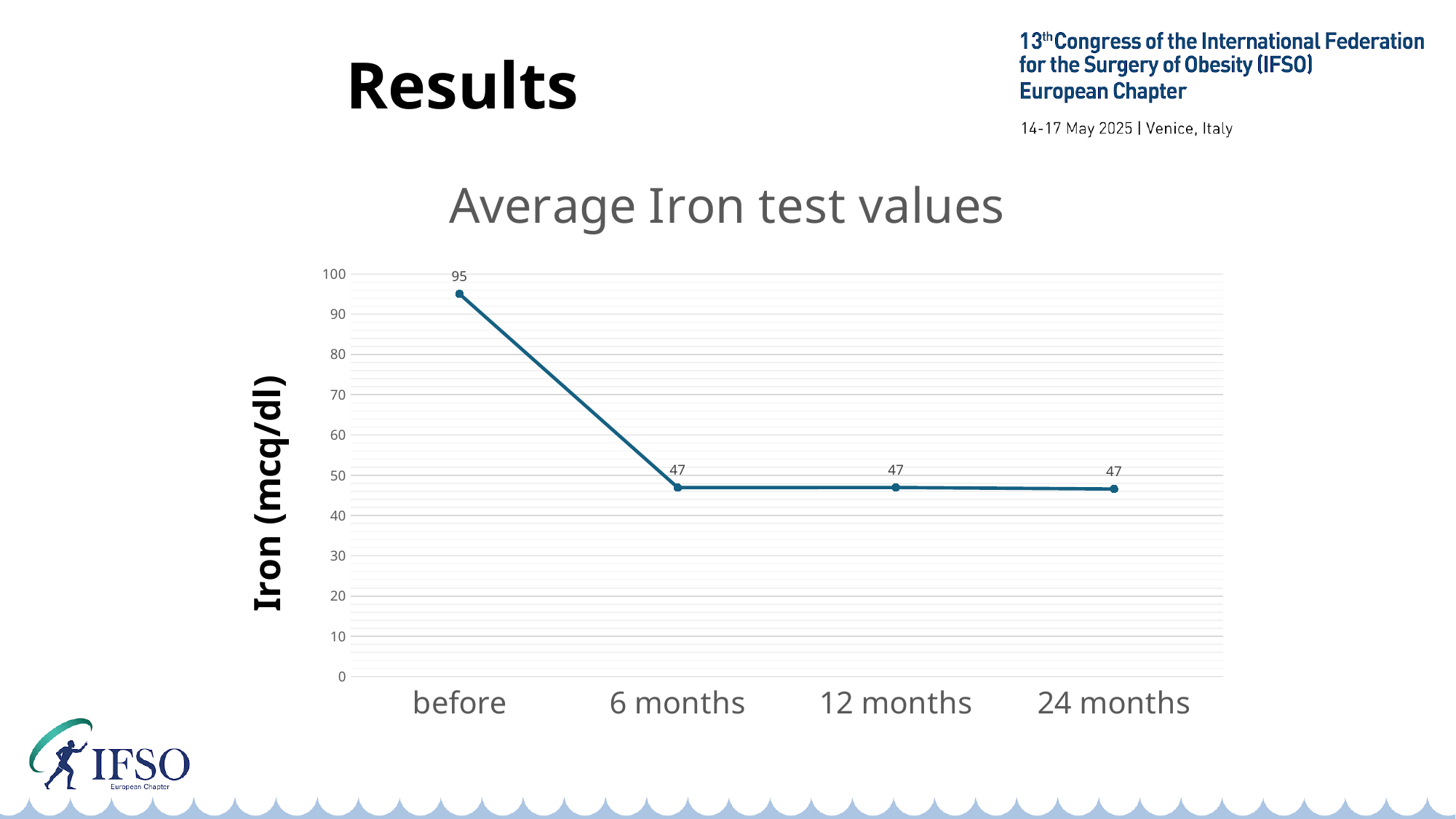
Which is larger, the iron value before or at 12 months? before What is the average iron test value at 6 months? 47 How many time points are plotted on the chart? 4 Is the iron value before surgery greater or less than 90? greater What is the difference between the iron value before and at 6 months? 48 What is the title of the chart? Average Iron test values Which time point has the highest average iron test value? before Do the iron values rise or fall from before to 6 months? fall What is the average iron test value at 24 months? 47 What is the average iron test value before surgery? 95 What kind of chart is shown? line chart Is the iron value at 12 months greater or less than 60? less